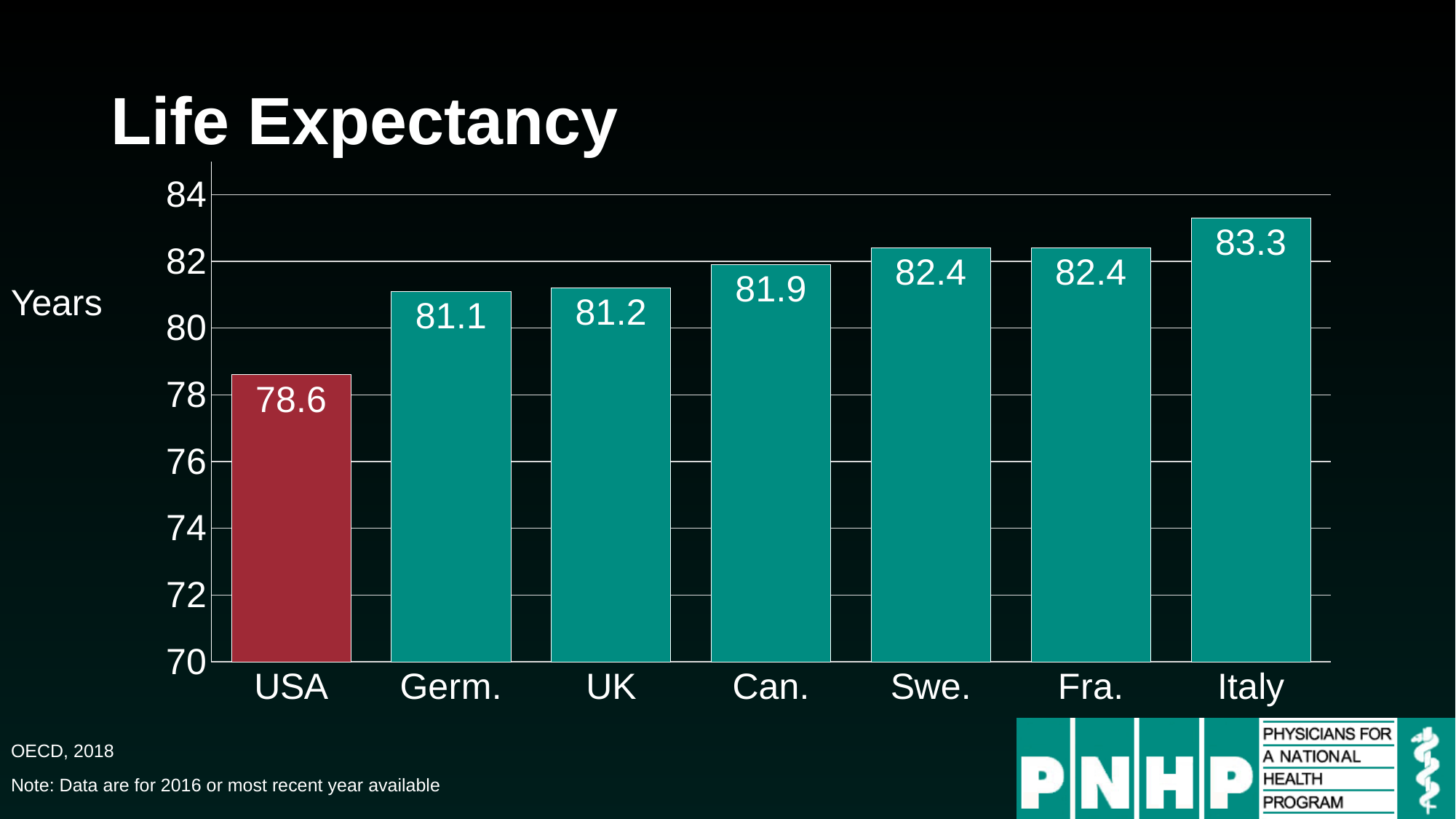
What is the difference in life expectancy between Italy and the USA? 4.7 Which country has the lowest life expectancy on the chart? USA What kind of chart is shown on the slide? bar chart What is the difference in life expectancy between the UK and Germany (Germ.)? 0.1 Which has a higher life expectancy, Canada (Can.) or the UK? Can. How many countries are shown on the chart? 7 What is the life expectancy value shown for Canada (Can.)? 81.9 What is the life expectancy value shown for the USA? 78.6 Which bar is coloured differently (red) from the others? USA Is the value for the USA greater or less than 80? less Which country has the highest life expectancy on the chart? Italy What is the life expectancy value shown for Italy? 83.3